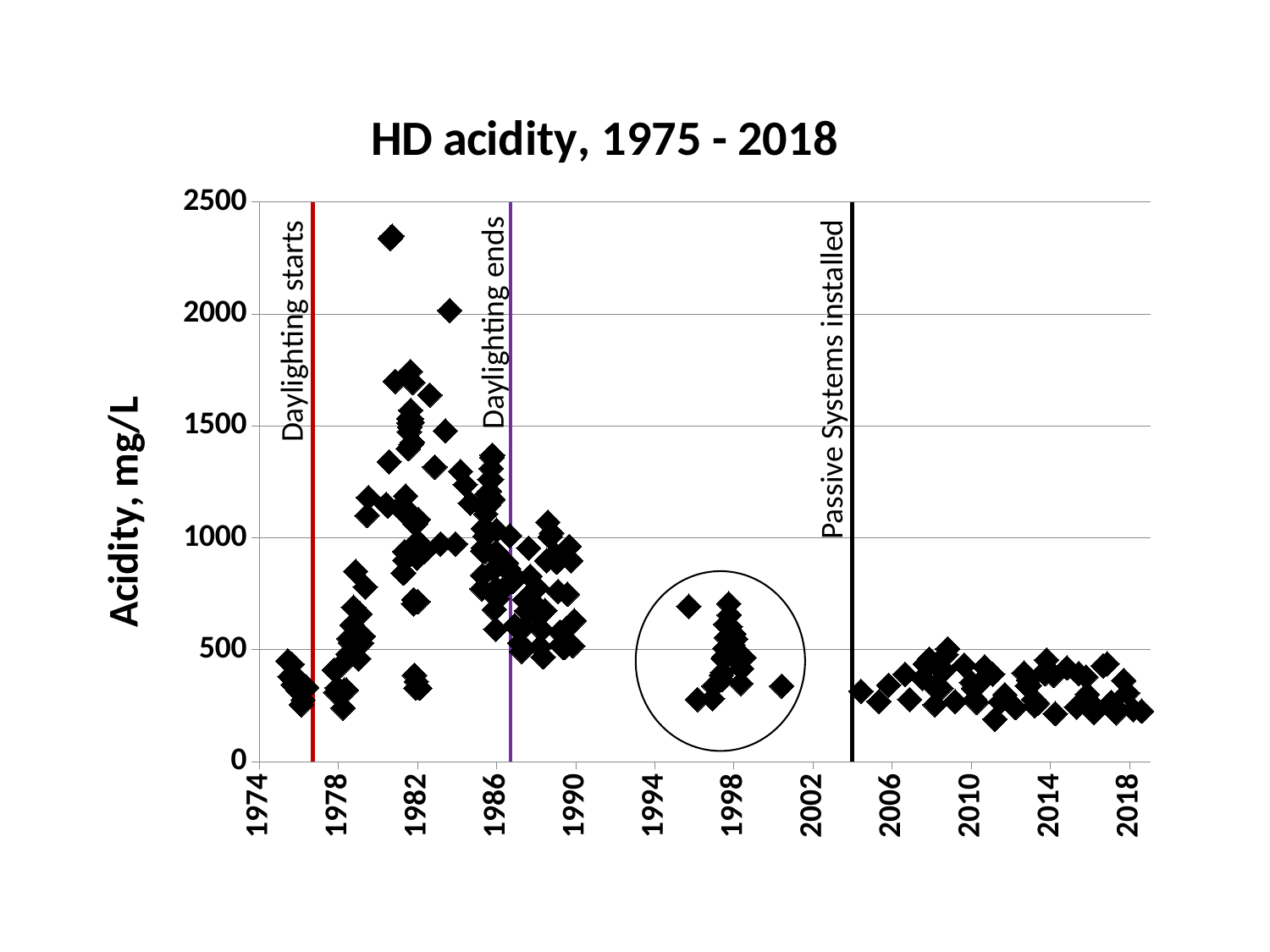
What is the title of the chart? HD acidity, 1975 - 2018 What event does the black vertical line on the chart mark? Passive Systems installed Are the acidity values after 2004 greater or less than 1000 mg/L? less Is the highest acidity point on the chart greater or less than 2000 mg/L? greater Are the circled acidity values between 1996 and 2000 greater or less than 1000 mg/L? less Do the acidity values generally rise or fall between 1986 and 1990? fall What kind of chart is shown on the slide? scatter chart Which period has higher acidity values: around 1981 or around 2010? around 1981 Overall, do acidity values rise or fall from the early 1980s to 2018? fall